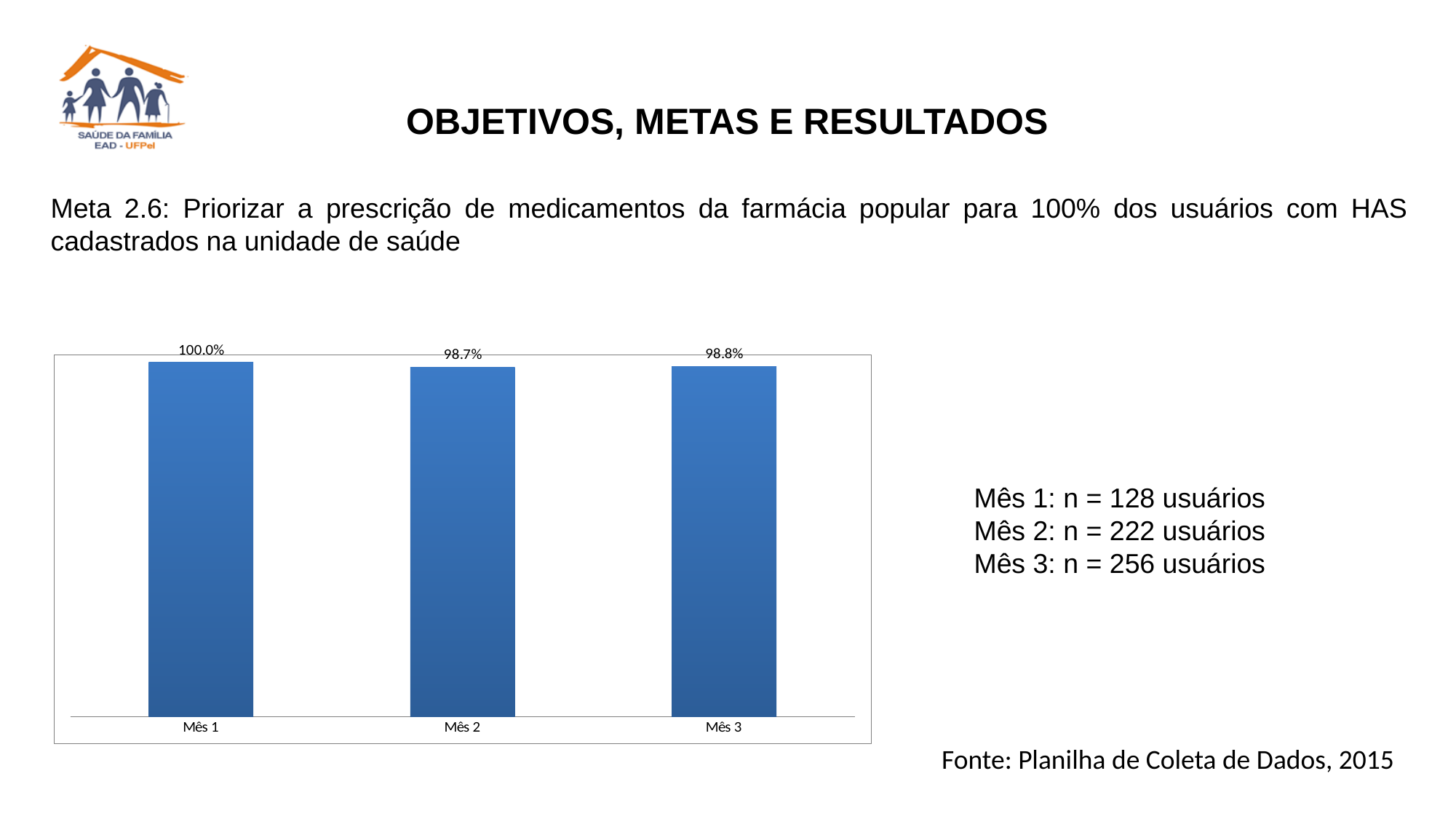
What colour are the bars in the chart? Blue What is the value shown for Mês 3? 98.8% What is the difference between the values for Mês 1 and Mês 3? 1.2% What is the difference between the values for Mês 1 and Mês 2? 1.3% What is the value shown for Mês 1? 100.0% What kind of chart is shown on the slide? Bar chart How many bars are plotted in the chart? 3 What is the value shown for Mês 2? 98.7% Does the value rise or fall from Mês 1 to Mês 2? Fall Which is larger, the value for Mês 1 or the value for Mês 2? Mês 1 Which month has the highest value in the chart? Mês 1 What is the difference between the values for Mês 3 and Mês 2? 0.1%